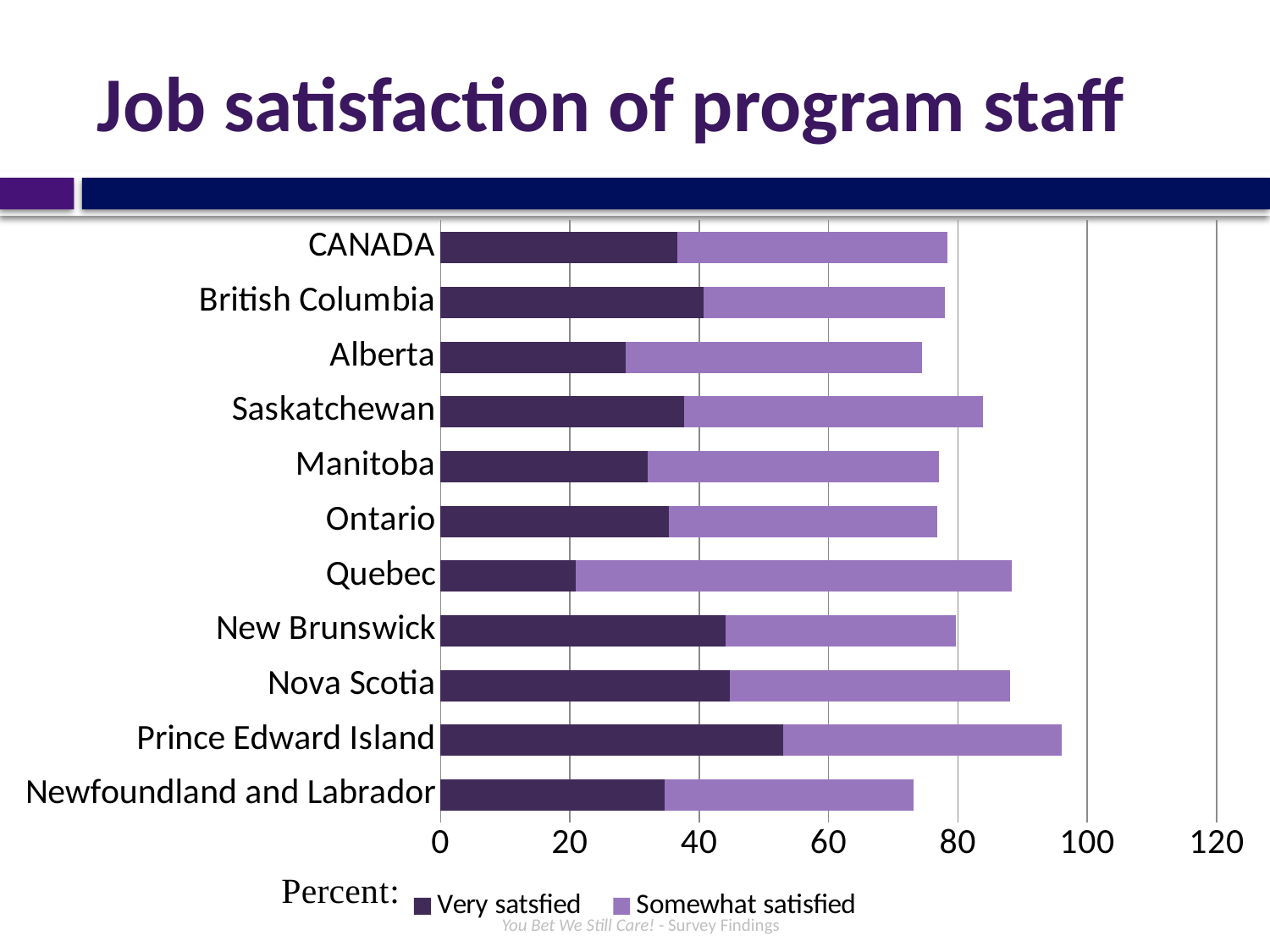
Which region has the smallest 'Very satsfied' segment? Quebec Which has the longer total bar, Prince Edward Island or Alberta? Prince Edward Island What kind of chart is shown on the slide? Stacked bar chart Which region has the largest 'Very satsfied' segment? Prince Edward Island Is the total bar length for Newfoundland and Labrador greater or less than 80? less Which region has the longest total bar (very satisfied plus somewhat satisfied)? Prince Edward Island Is the 'Very satsfied' value for Prince Edward Island greater or less than 40? greater What are the two legend entries on the chart? Very satsfied; Somewhat satisfied How many series does the legend list? 2 Is the 'Very satsfied' value for Quebec greater or less than 40? less How many categories (regions) are plotted on the chart? 11